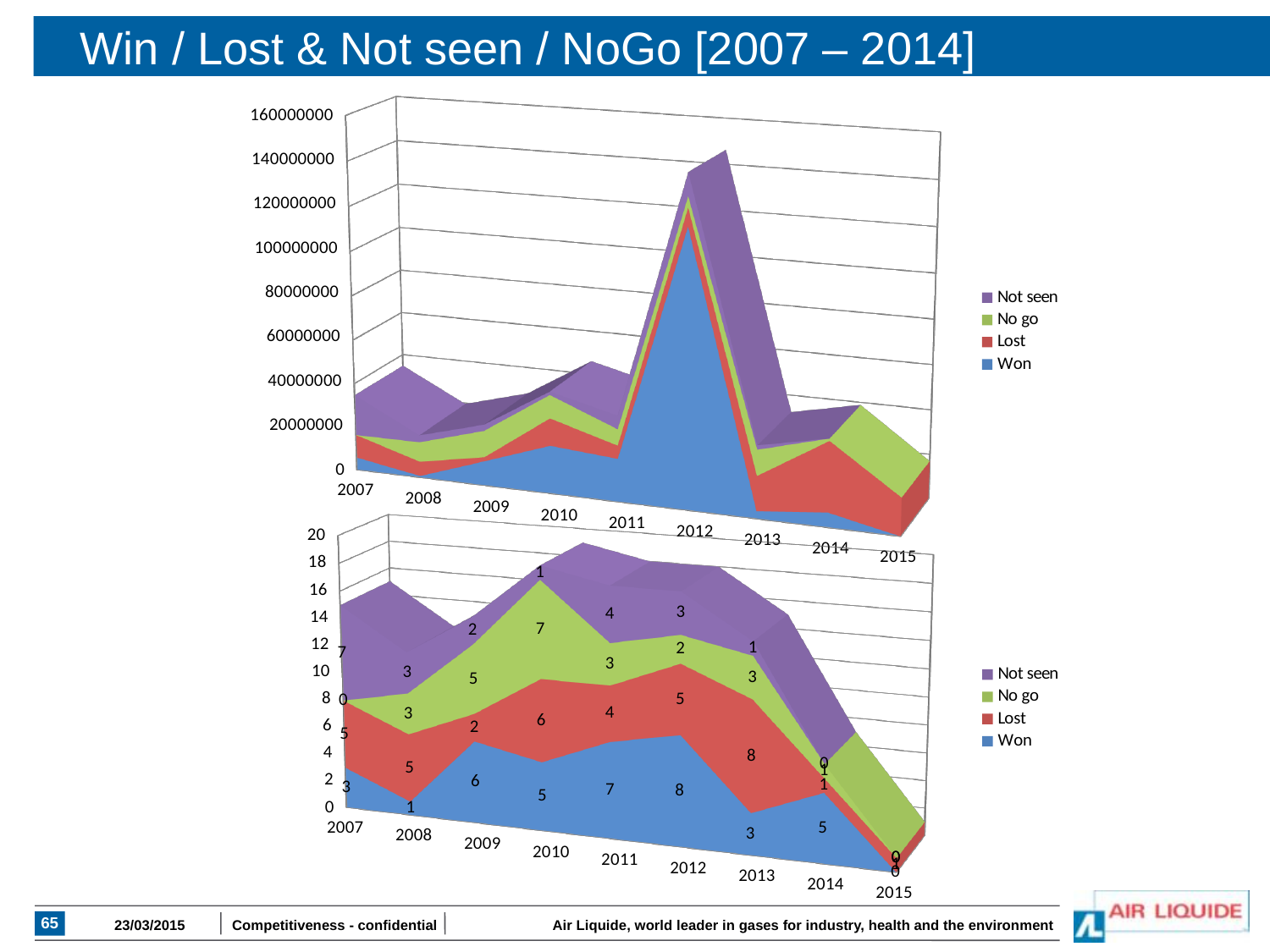
In the top chart, is the total stacked value for 2012 greater or less than 120000000? greater In the bottom chart, what is the value for No go in 2010? 7 How many series does the legend of the top chart list? 4 In the bottom chart, what is the value for Not seen in 2007? 7 What kind of chart is the top chart? Stacked area chart In the bottom chart, which is larger in 2009: Won or No go? Won In the bottom chart, which year has the highest Won value? 2012 In the bottom chart, what is the total of all four series in 2010? 19 In the bottom chart, what is the difference between Lost and Won in 2013? 5 In the bottom chart, what is the value for Lost in 2013? 8 In the bottom chart, what is the value for Won in 2012? 8 In the bottom chart, which year has the lowest Won value among 2007 to 2014? 2008